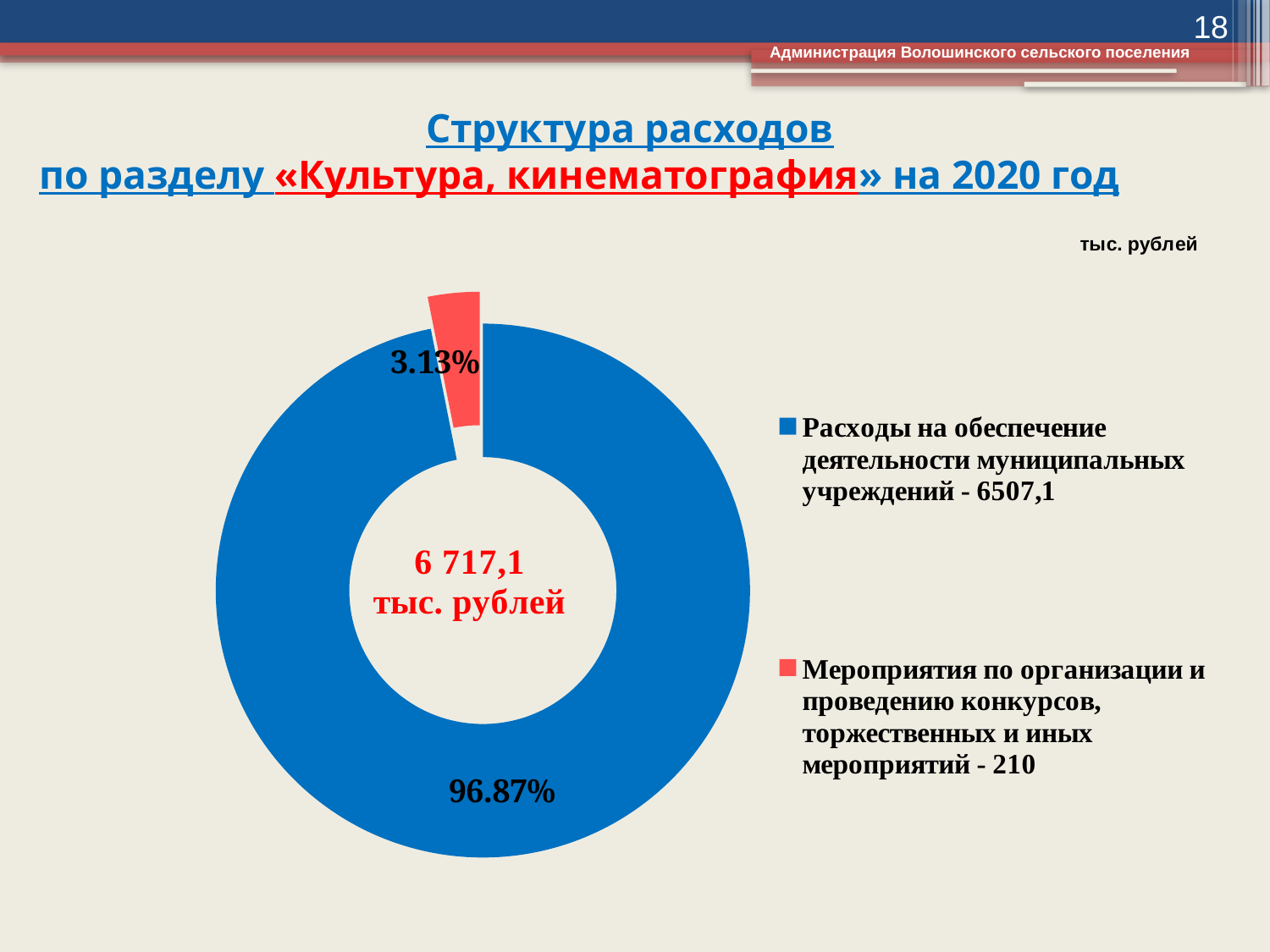
What total amount is printed in the centre of the chart? 6 717,1 тыс. рублей What percentage share is shown for the slice 'Мероприятия по организации и проведению конкурсов, торжественных и иных мероприятий'? 3.13% Which category has the largest share of the chart? Расходы на обеспечение деятельности муниципальных учреждений What colour is the slice representing 'Мероприятия по организации и проведению конкурсов, торжественных и иных мероприятий'? Red What percentage share is shown for the slice 'Расходы на обеспечение деятельности муниципальных учреждений'? 96.87% Which category has the smallest share of the chart? Мероприятия по организации и проведению конкурсов, торжественных и иных мероприятий How many entries does the legend list? 2 What value (in thousand rubles) does the legend give for 'Расходы на обеспечение деятельности муниципальных учреждений'? 6507,1 What value (in thousand rubles) does the legend give for 'Мероприятия по организации и проведению конкурсов, торжественных и иных мероприятий'? 210 How many slices does the chart have? 2 What kind of chart is shown on the slide? Doughnut (pie) chart Which is larger: the share for 'Расходы на обеспечение деятельности муниципальных учреждений' or the share for 'Мероприятия по организации и проведению конкурсов, торжественных и иных мероприятий'? Расходы на обеспечение деятельности муниципальных учреждений